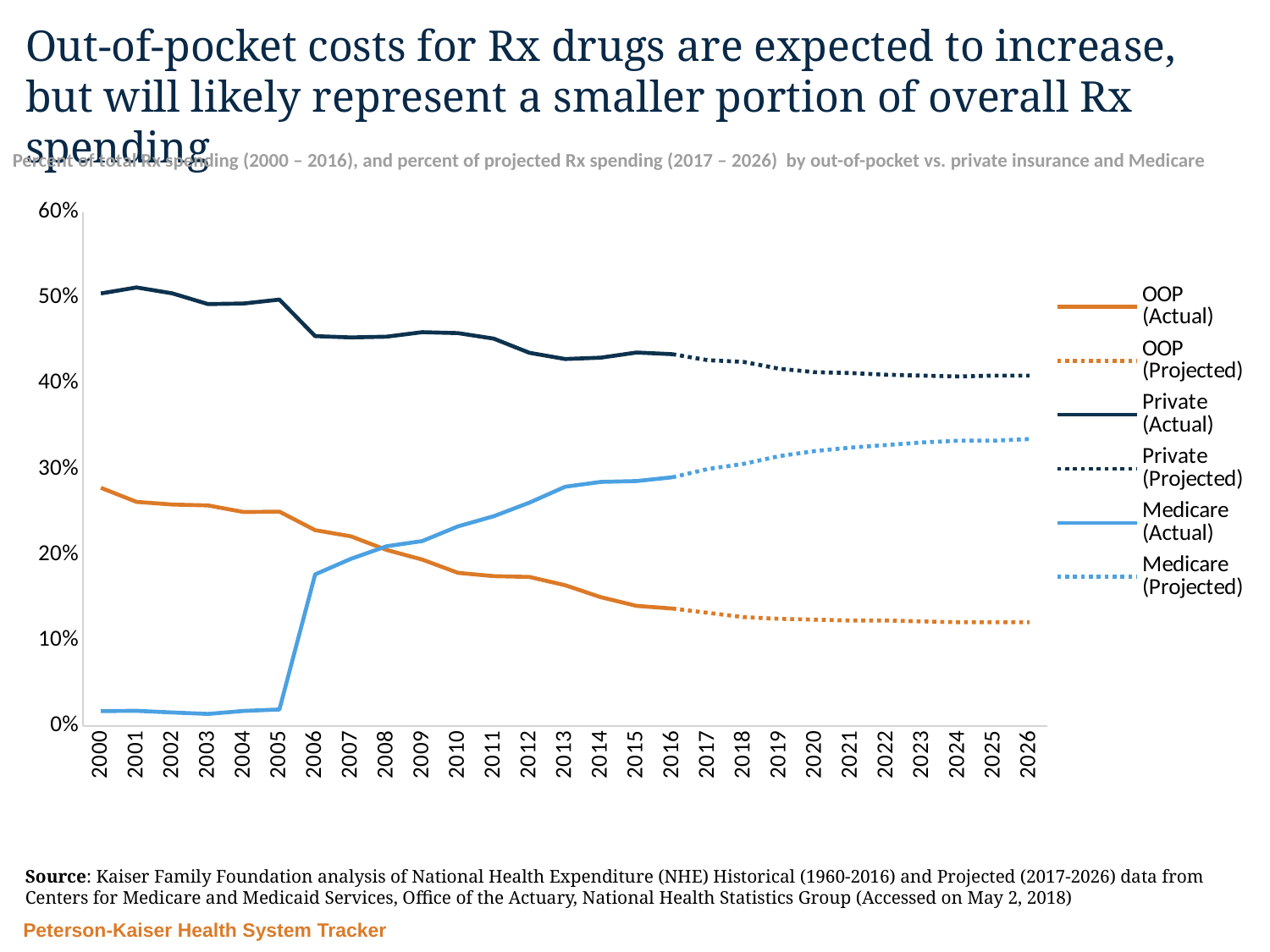
Does the Medicare (Actual) line rise or fall from 2000 to 2016? rise Is the value for OOP (Projected) in 2026 greater or less than 20%? less Is the value for Medicare (Actual) in 2000 greater or less than 10%? less Does the OOP (Actual) line rise or fall from 2000 to 2016? fall In 2016, which is larger, Medicare (Actual) or OOP (Actual)? Medicare (Actual) Which series has the highest value in 2026? Private (Projected) How many series does the legend list? 6 What colour is used for the OOP lines? orange What kind of chart is shown on the slide? line chart How many years are shown along the x axis? 27 Is the value for Medicare (Projected) in 2026 greater or less than 30%? greater